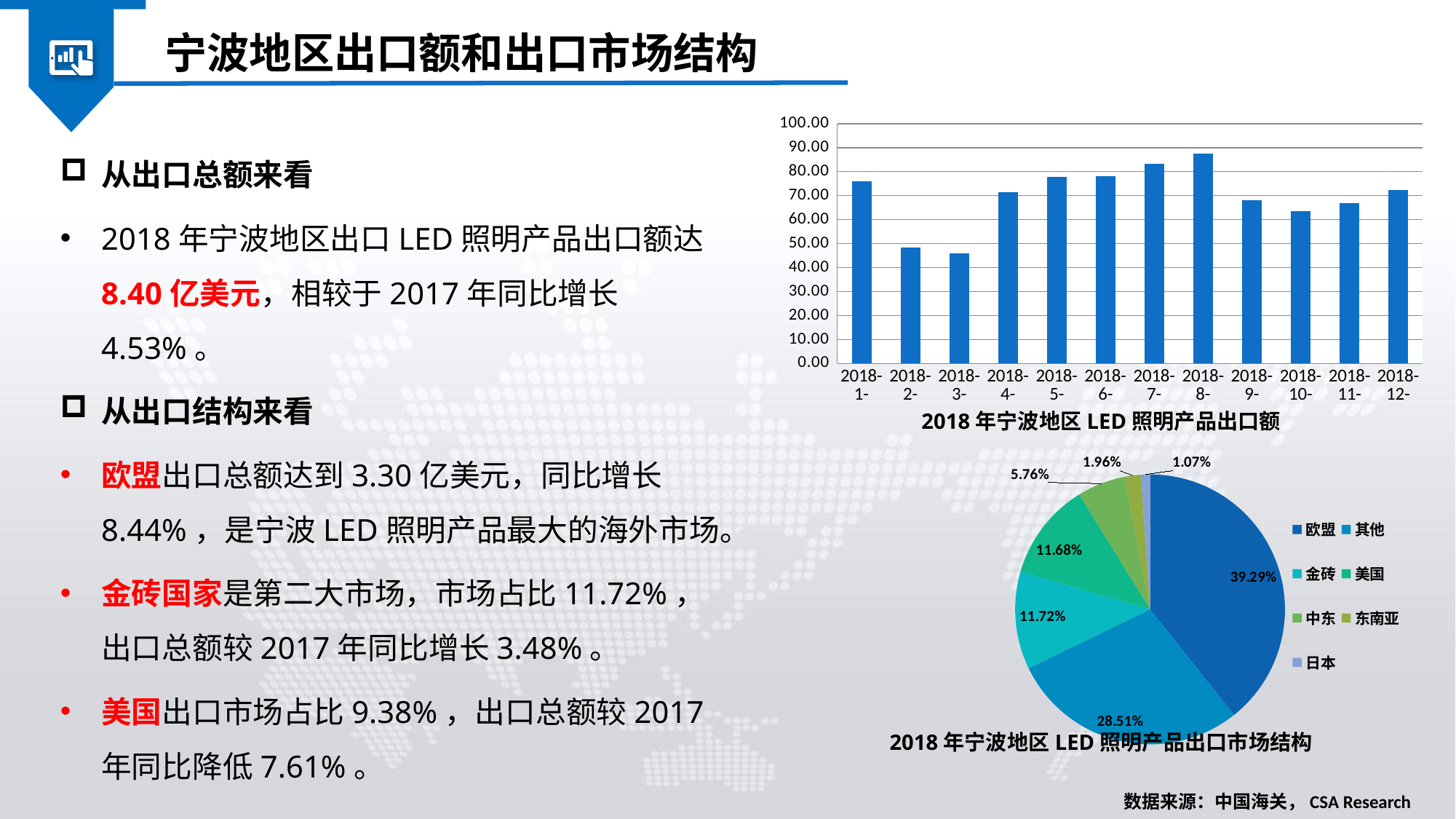
In the pie chart titled 2018年宁波地区LED照明产品出口市场结构, what is the difference between the shares of 欧盟 and 其他? 10.78% In the chart titled 2018年宁波地区LED照明产品出口额, is the value for 2018-8 greater or less than 80.00? greater In the chart titled 2018年宁波地区LED照明产品出口额, is the value for 2018-2 greater or less than 50.00? less In the chart titled 2018年宁波地区LED照明产品出口额, which is larger, the value for 2018-7 or the value for 2018-9? 2018-7 What type of chart is the chart titled 2018年宁波地区LED照明产品出口额? bar chart In the chart titled 2018年宁波地区LED照明产品出口额, which month has the highest value? 2018-8 In the chart titled 2018年宁波地区LED照明产品出口额, how many months (bars) are shown? 12 In the pie chart titled 2018年宁波地区LED照明产品出口市场结构, what is the value for 日本? 1.07% How many entries does the legend of the pie chart titled 2018年宁波地区LED照明产品出口市场结构 list? 7 In the pie chart titled 2018年宁波地区LED照明产品出口市场结构, what is the value for 其他? 28.51% In the chart titled 2018年宁波地区LED照明产品出口额, which month has the lowest value? 2018-3 In the pie chart titled 2018年宁波地区LED照明产品出口市场结构, what share does 欧盟 have? 39.29%